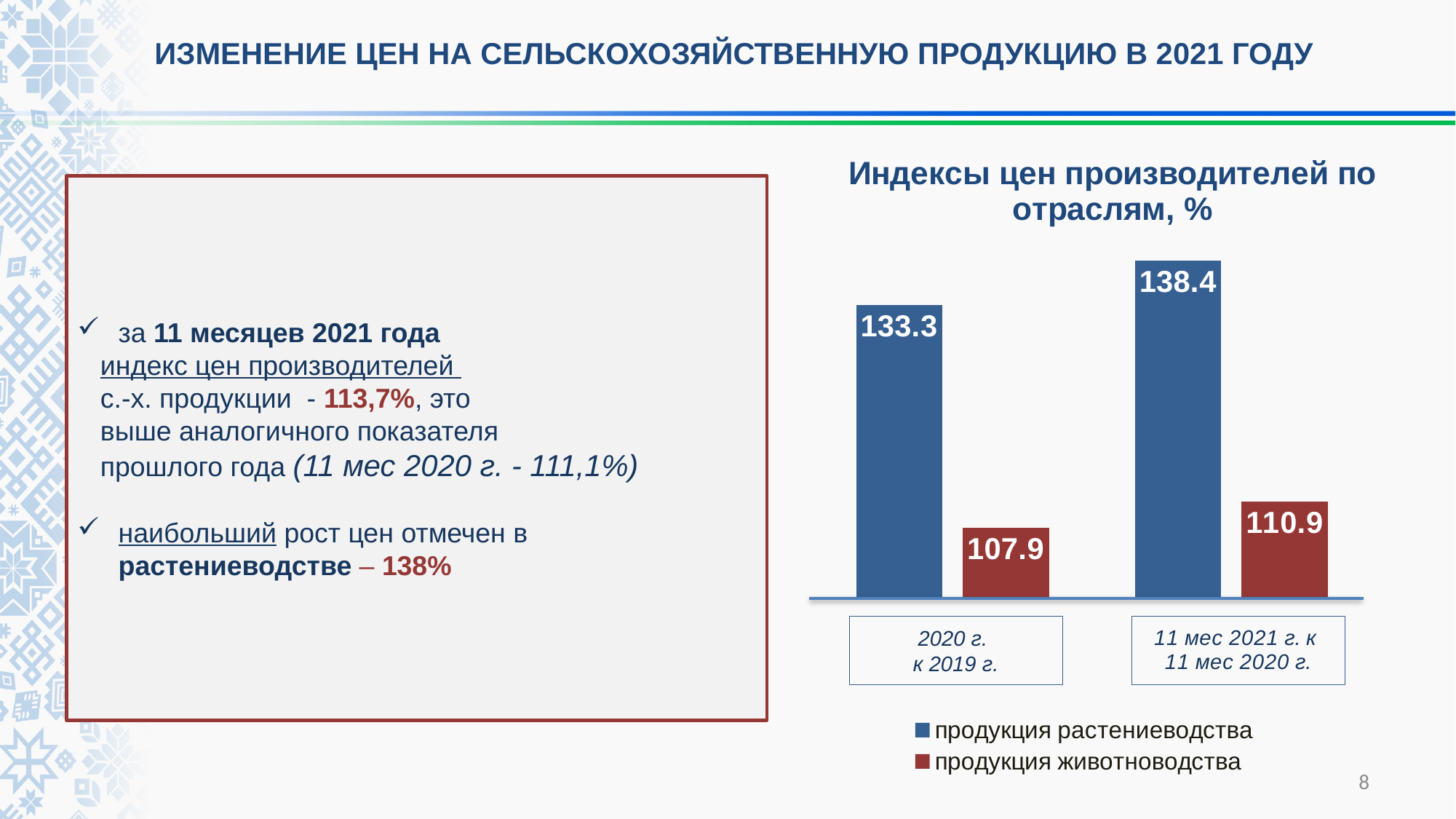
Which bar has the lowest value on the chart? продукция животноводства, 2020 г. к 2019 г. What kind of chart is shown on the slide? bar chart What is the value for продукция растениеводства in the category 2020 г. к 2019 г.? 133.3 How many categories are shown on the x axis of the chart? 2 What is the difference between продукция растениеводства and продукция животноводства in the category 2020 г. к 2019 г.? 25.4 What is the difference between the продукция растениеводства values for 11 мес 2021 г. к 11 мес 2020 г. and 2020 г. к 2019 г.? 5.1 What is the value for продукция растениеводства in the category 11 мес 2021 г. к 11 мес 2020 г.? 138.4 What is the value for продукция животноводства in the category 2020 г. к 2019 г.? 107.9 Which is larger in the category 11 мес 2021 г. к 11 мес 2020 г.: продукция растениеводства or продукция животноводства? продукция растениеводства How many series does the chart legend list? 2 What is the value for продукция животноводства in the category 11 мес 2021 г. к 11 мес 2020 г.? 110.9 Which bar has the highest value on the chart? продукция растениеводства, 11 мес 2021 г. к 11 мес 2020 г.